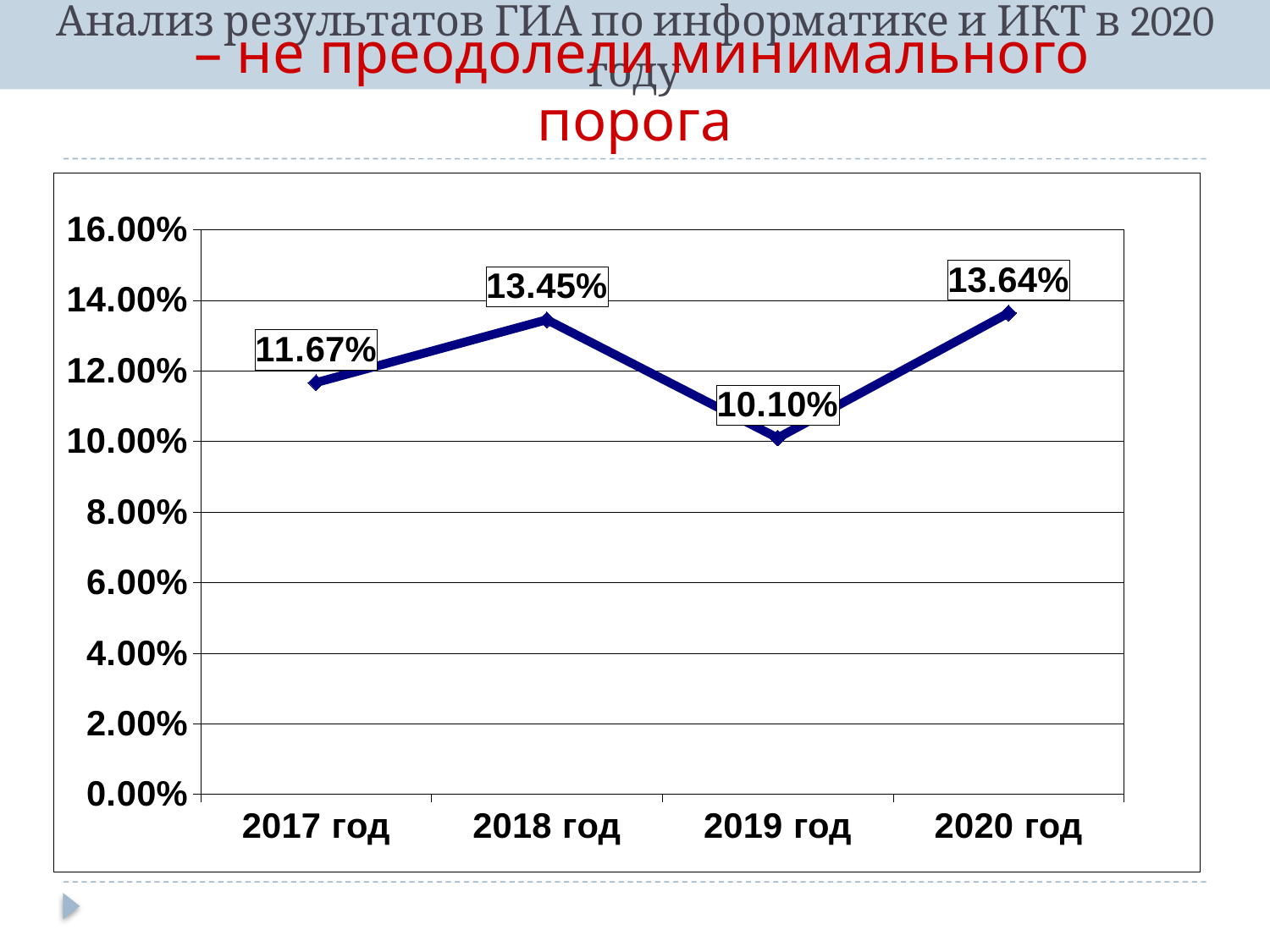
What is the value for 2018 год? 13.45% Which year has the lowest value? 2019 год How many years are plotted on the chart? 4 What is the value for 2020 год? 13.64% Does the value rise or fall from 2019 год to 2020 год? rise Is the value for 2019 год greater or less than 12.00%? less Which year has the highest value? 2020 год What is the value for 2017 год? 11.67% Which is larger, the value for 2017 год or the value for 2018 год? 2018 год What is the value for 2019 год? 10.10% What kind of chart is shown on the slide? line chart What is the difference between the values for 2018 год and 2019 год? 3.35%